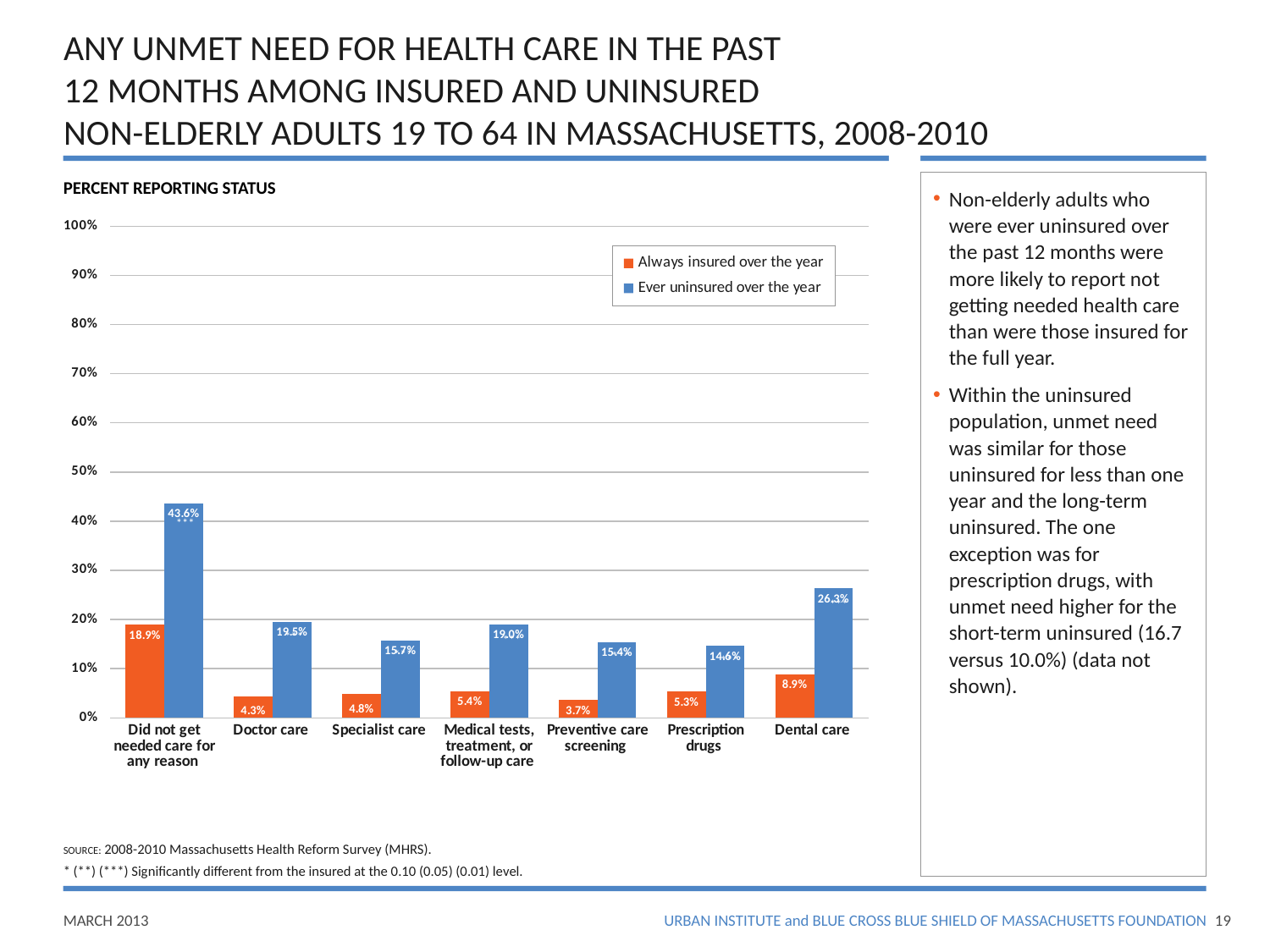
What is the value for 'Ever uninsured over the year' for 'Did not get needed care for any reason'? 43.6% Which category has the lowest value for 'Always insured over the year'? Preventive care screening What is the value for 'Always insured over the year' for Preventive care screening? 3.7% What is the value for 'Always insured over the year' for Dental care? 8.9% What kind of chart is shown on the slide? Bar chart How many series does the legend list? 2 Is the 'Ever uninsured over the year' value for Dental care greater or less than 20%? greater What is the value for 'Ever uninsured over the year' for Prescription drugs? 14.6% Which category has the highest value for 'Ever uninsured over the year'? Did not get needed care for any reason How many categories are shown on the x axis? 7 Which is larger for Specialist care: the 'Always insured over the year' value or the 'Ever uninsured over the year' value? Ever uninsured over the year What is the difference between the 'Ever uninsured over the year' and 'Always insured over the year' values for Doctor care? 15.2%